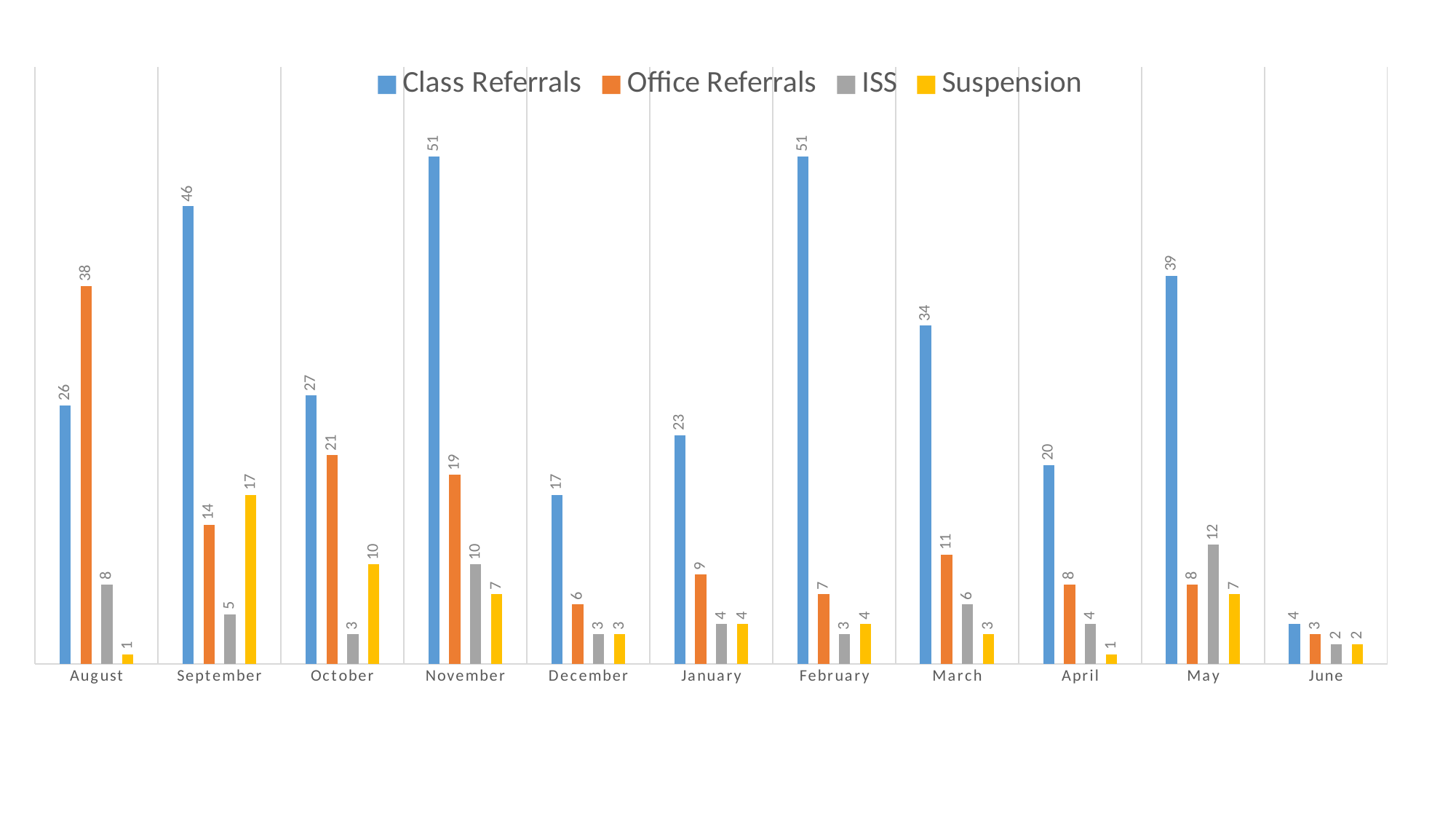
How many series does the legend list? 4 What is the Suspension value for September? 17 Which is larger in August: Class Referrals or Office Referrals? Office Referrals How many months are shown on the x axis? 11 Which month has the highest Suspension value? September What is the value of Office Referrals for August? 38 What is the value of Class Referrals for November? 51 Which month has the lowest Class Referrals value? June What is the difference between Class Referrals and Office Referrals in October? 6 Which month has the highest Office Referrals value? August What kind of chart is shown on the slide? Bar chart What is the ISS value for May? 12